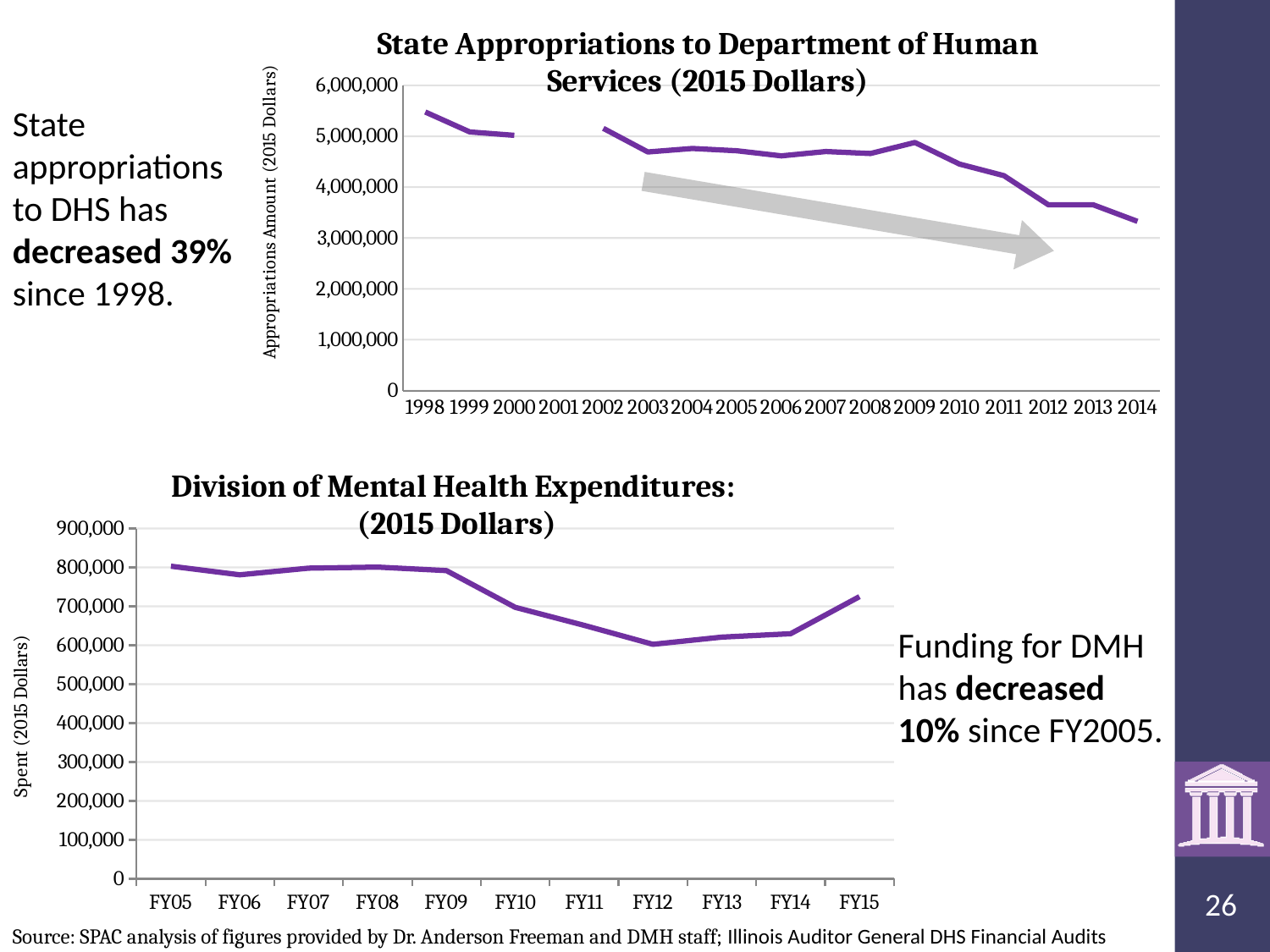
What kind of chart is the 'Division of Mental Health Expenditures: (2015 Dollars)' chart? line chart What kind of chart is the 'State Appropriations to Department of Human Services (2015 Dollars)' chart? line chart In the 'State Appropriations to Department of Human Services' chart, is the value for 2014 greater or less than 4,000,000? less In the 'Division of Mental Health Expenditures' chart, which fiscal year has the lowest value? FY12 In the 'State Appropriations to Department of Human Services' chart, do the values generally rise or fall from 1998 to 2014? fall In the 'Division of Mental Health Expenditures' chart, how many fiscal years are shown on the x axis? 11 In the 'State Appropriations to Department of Human Services' chart, which year has the highest value? 1998 In the 'Division of Mental Health Expenditures' chart, which is larger, the value for FY15 or the value for FY12? FY15 In the 'State Appropriations to Department of Human Services' chart, is the value for 2009 greater or less than 4,000,000? greater In the 'Division of Mental Health Expenditures' chart, is the value for FY05 greater or less than 700,000? greater In the 'State Appropriations to Department of Human Services' chart, which year has the lowest value? 2014